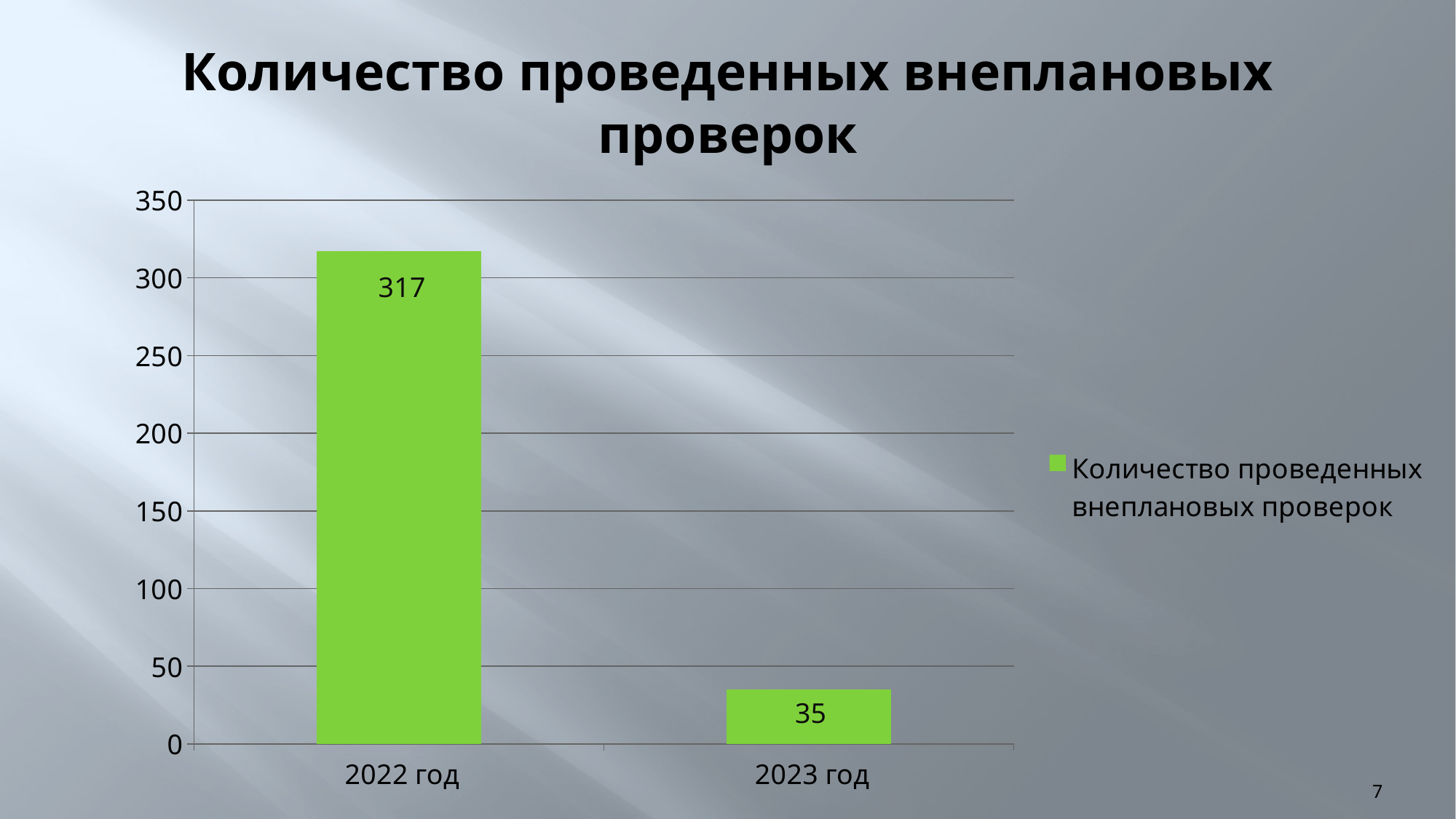
How many categories are shown on the x axis? 2 Do the values rise or fall from 2022 год to 2023 год? fall What is the value for 2022 год? 317 What is the difference between the values for 2022 год and 2023 год? 282 What kind of chart is shown on the slide? bar chart Which is larger, the value for 2022 год or the value for 2023 год? 2022 год Is the value for 2022 год greater or less than 300? greater Is the value for 2023 год greater or less than 50? less Which year has the lowest number of unscheduled inspections? 2023 год What is the value for 2023 год? 35 Which year has the highest number of unscheduled inspections? 2022 год How many series does the legend list? 1